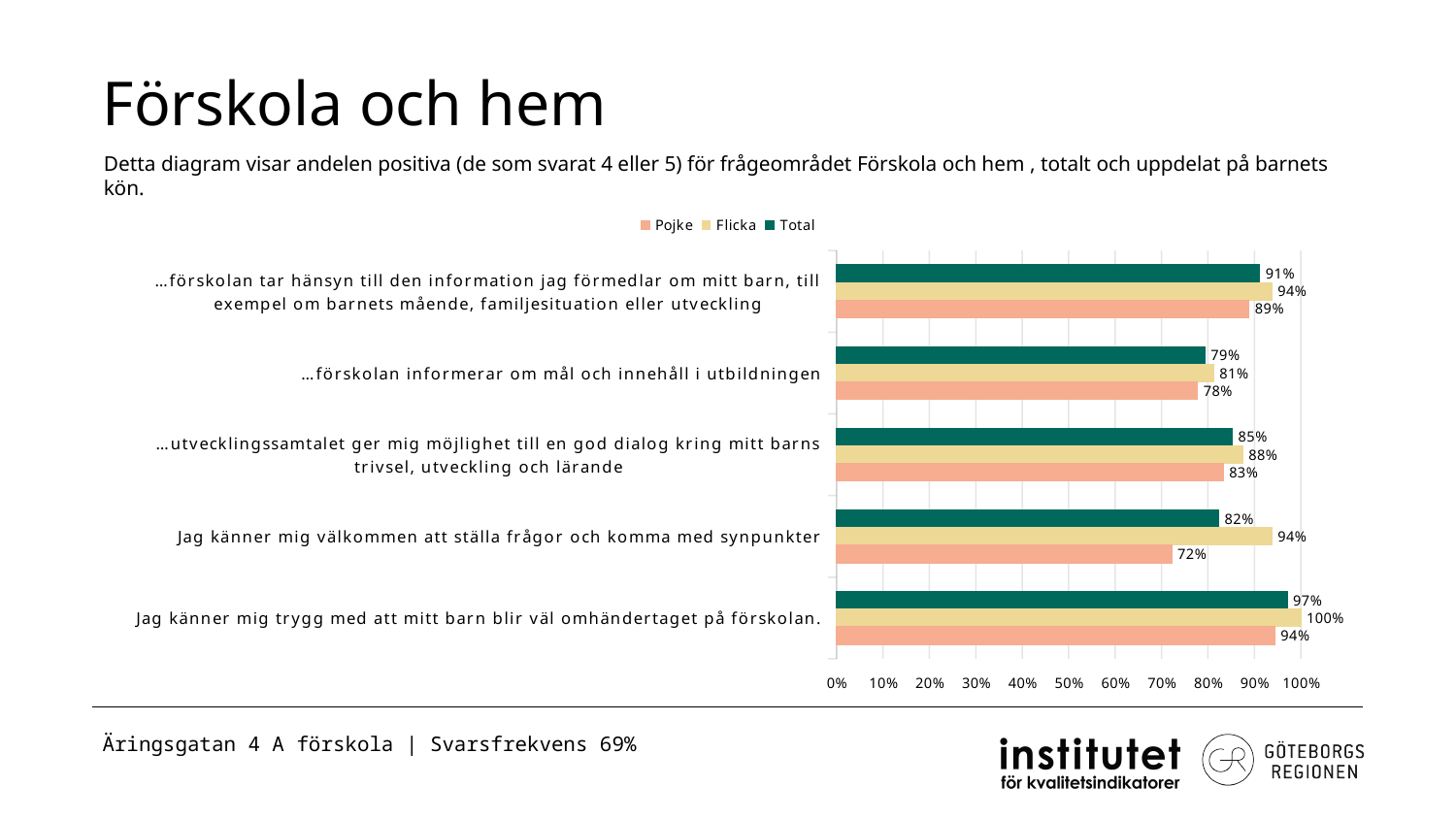
What is the difference between the Flicka and Pojke values for "Jag känner mig välkommen att ställa frågor och komma med synpunkter"? 22% Which is larger for "…utvecklingssamtalet ger mig möjlighet till en god dialog kring mitt barns trivsel, utveckling och lärande": the Pojke value or the Flicka value? Flicka What kind of chart is shown on the slide? Bar chart How many series does the legend list? 3 What is the Pojke value for "Jag känner mig välkommen att ställa frågor och komma med synpunkter"? 72% Is the Pojke value for "…förskolan informerar om mål och innehåll i utbildningen" greater or less than 80%? less Which category has the lowest Total value? …förskolan informerar om mål och innehåll i utbildningen What is the Total value for "Jag känner mig trygg med att mitt barn blir väl omhändertaget på förskolan."? 97% How many categories (statements) are shown in the chart? 5 Which series is shown in green in the chart? Total What is the Flicka value for "…förskolan informerar om mål och innehåll i utbildningen"? 81% Which category has the highest Flicka value? Jag känner mig trygg med att mitt barn blir väl omhändertaget på förskolan.